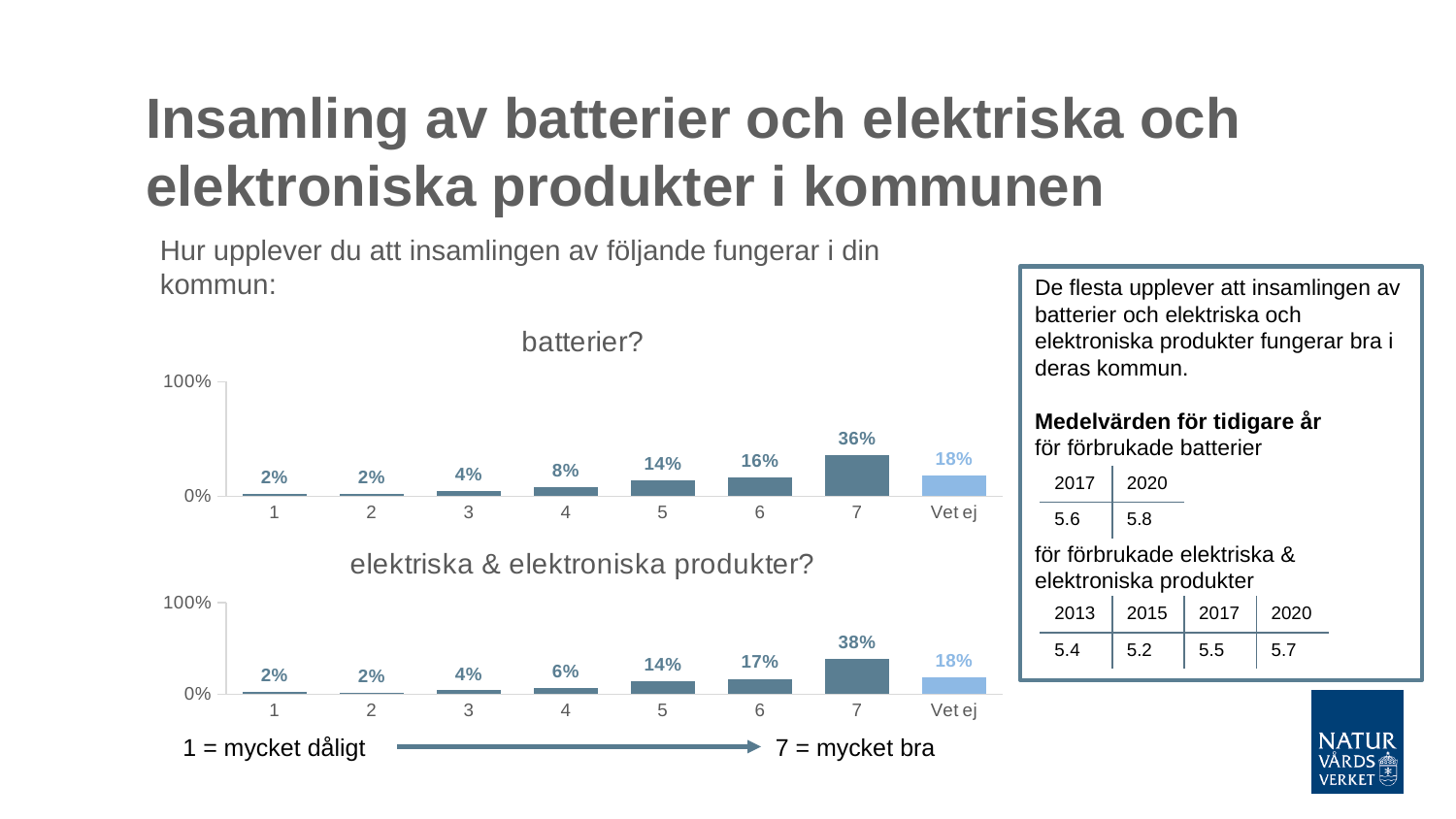
In the 'batterier?' chart, what is the value for category 4? 8% In the 'elektriska & elektroniska produkter?' chart, which category has the highest value? 7 In the 'elektriska & elektroniska produkter?' chart, what is the difference between the values for category 7 and category 6? 21% In the 'batterier?' chart, what is the difference between the values for category 7 and 'Vet ej'? 18% In the 'batterier?' chart, what is the value for category 7? 36% In the 'elektriska & elektroniska produkter?' chart, which is larger, the value for category 5 or category 6? 6 In the 'batterier?' chart, which category has the highest value? 7 In the 'batterier?' chart, do the values rise or fall from category 1 to category 7? rise How many categories are shown on the x axis of the 'batterier?' chart? 8 In the 'elektriska & elektroniska produkter?' chart, what is the value for 'Vet ej'? 18% In the 'elektriska & elektroniska produkter?' chart, what is the value for category 6? 17% What kind of chart is the 'batterier?' chart? bar chart